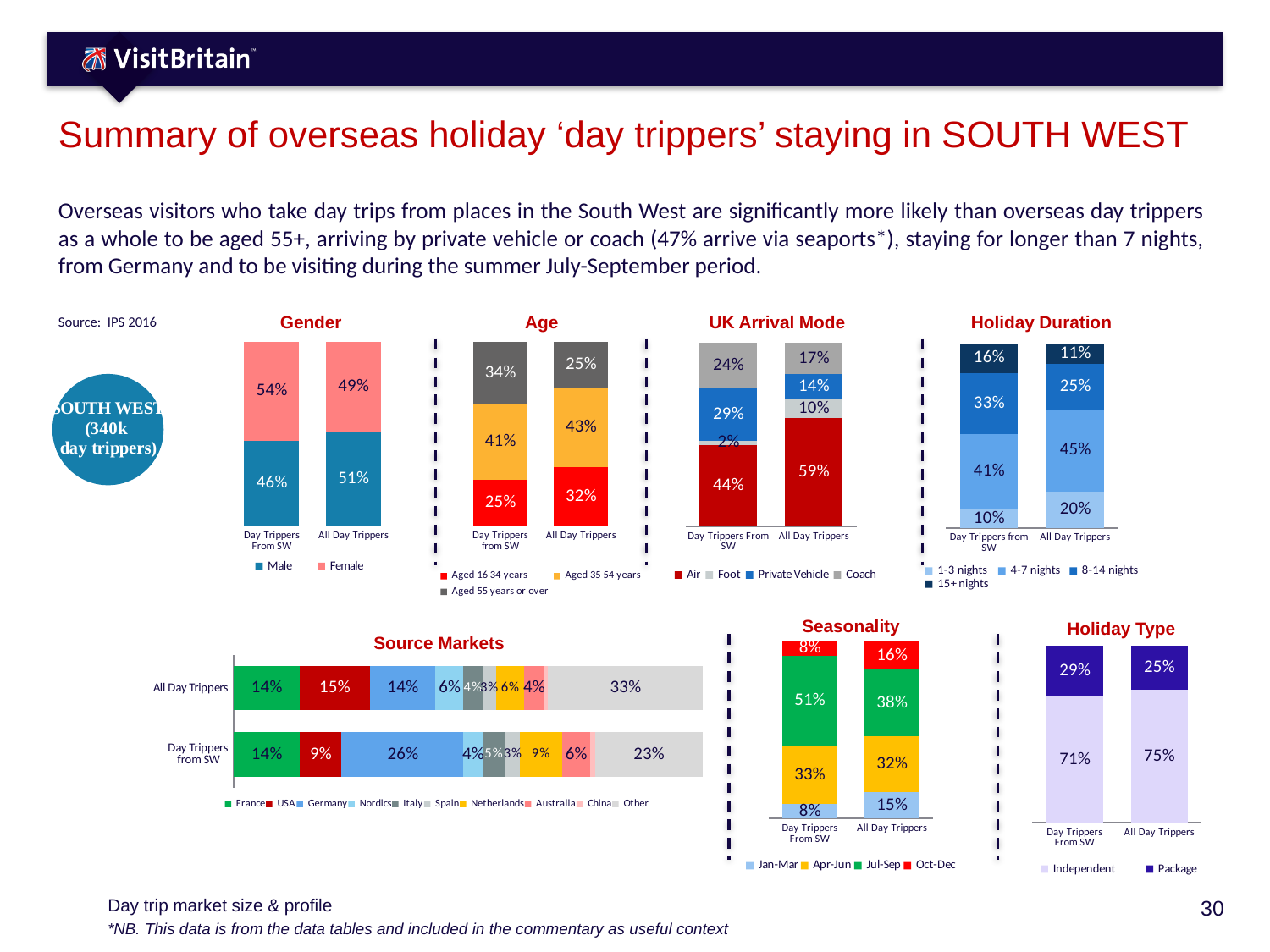
In the Holiday Duration chart, what is the difference between the 4-7 nights share for All Day Trippers and for Day Trippers from SW? 4% In the UK Arrival Mode chart, which arrival mode has the lowest share for Day Trippers From SW? Foot In the Gender chart, what percentage of Day Trippers From SW are female? 54% In the UK Arrival Mode chart, what percentage of Day Trippers From SW arrive by air? 44% In the Source Markets chart, which source market has the largest share for All Day Trippers, excluding Other? USA In the Holiday Duration chart, which group has the larger share of 15+ nights stays, Day Trippers from SW or All Day Trippers? Day Trippers from SW In the Seasonality chart, what percentage of Day Trippers From SW visit in Jul-Sep? 51% What type of chart is the Source Markets chart? Stacked bar chart In the Holiday Type chart, what is the difference between the Independent share for All Day Trippers and for Day Trippers From SW? 4% In the Age chart, what percentage of All Day Trippers are aged 35-54 years? 43% How many series does the legend of the Seasonality chart list? 4 In the Source Markets chart, what percentage of Day Trippers from SW come from Germany? 26%